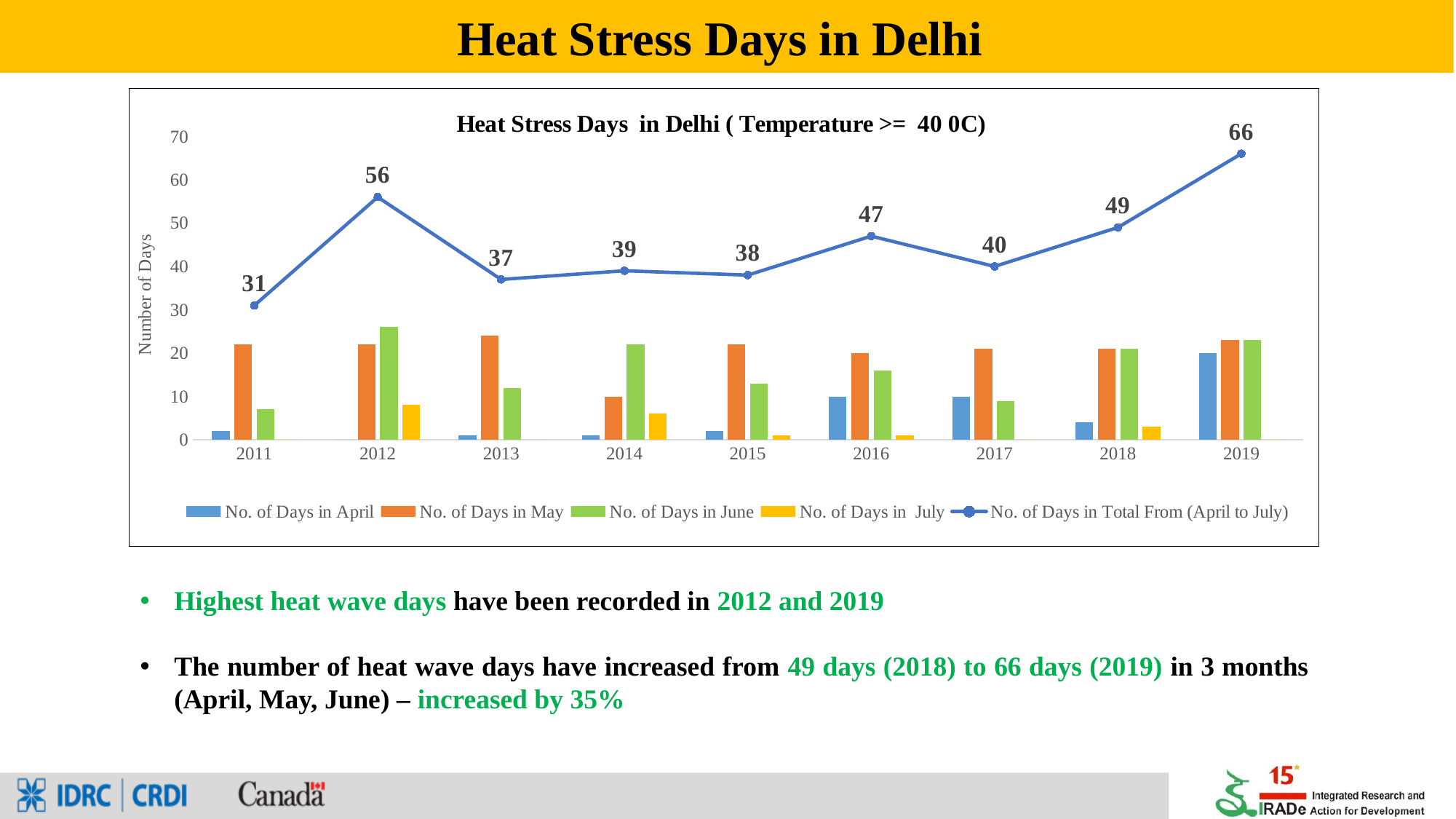
How many series does the legend list? 5 Which year has the lowest No. of Days in Total From (April to July)? 2011 Between 2017 and 2019, does the No. of Days in Total From (April to July) rise or fall? rise Which year has a larger total number of days, 2016 or 2017? 2016 How many years are shown on the x axis? 9 What is the difference between the total days in 2019 and the total days in 2018? 17 Which year has the highest No. of Days in Total From (April to July)? 2019 What is the value of No. of Days in Total From (April to July) for 2016? 47 What is the value of No. of Days in Total From (April to July) for 2012? 56 Is the value for No. of Days in July in 2014 greater or less than 10? less What is the value of No. of Days in Total From (April to July) for 2019? 66 Is the value for No. of Days in May in 2013 greater or less than 20? greater